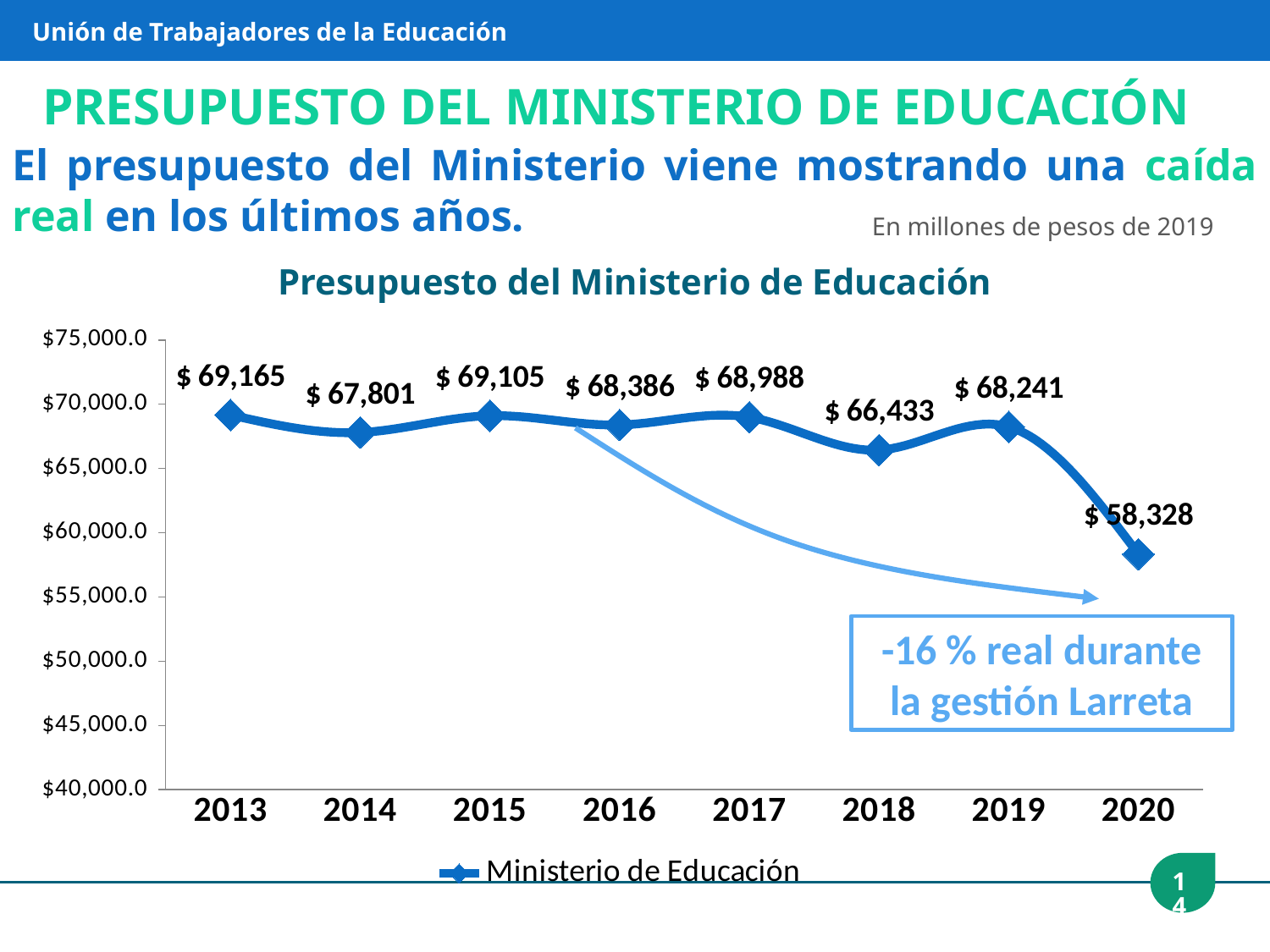
What series name does the legend show? Ministerio de Educación What kind of chart is shown? line chart How many years are plotted on the chart? 8 Which year has the highest value? 2013 What is the value for 2013? $ 69,165 What is the difference between the values for 2017 and 2018? 2,555 Which year has the lowest value? 2020 Which is larger, the value for 2014 or the value for 2015? 2015 What is the difference between the values for 2019 and 2020? 9,913 What is the value for 2018? $ 66,433 What is the value for 2020? $ 58,328 Is the value for 2020 greater or less than $60,000.0? less